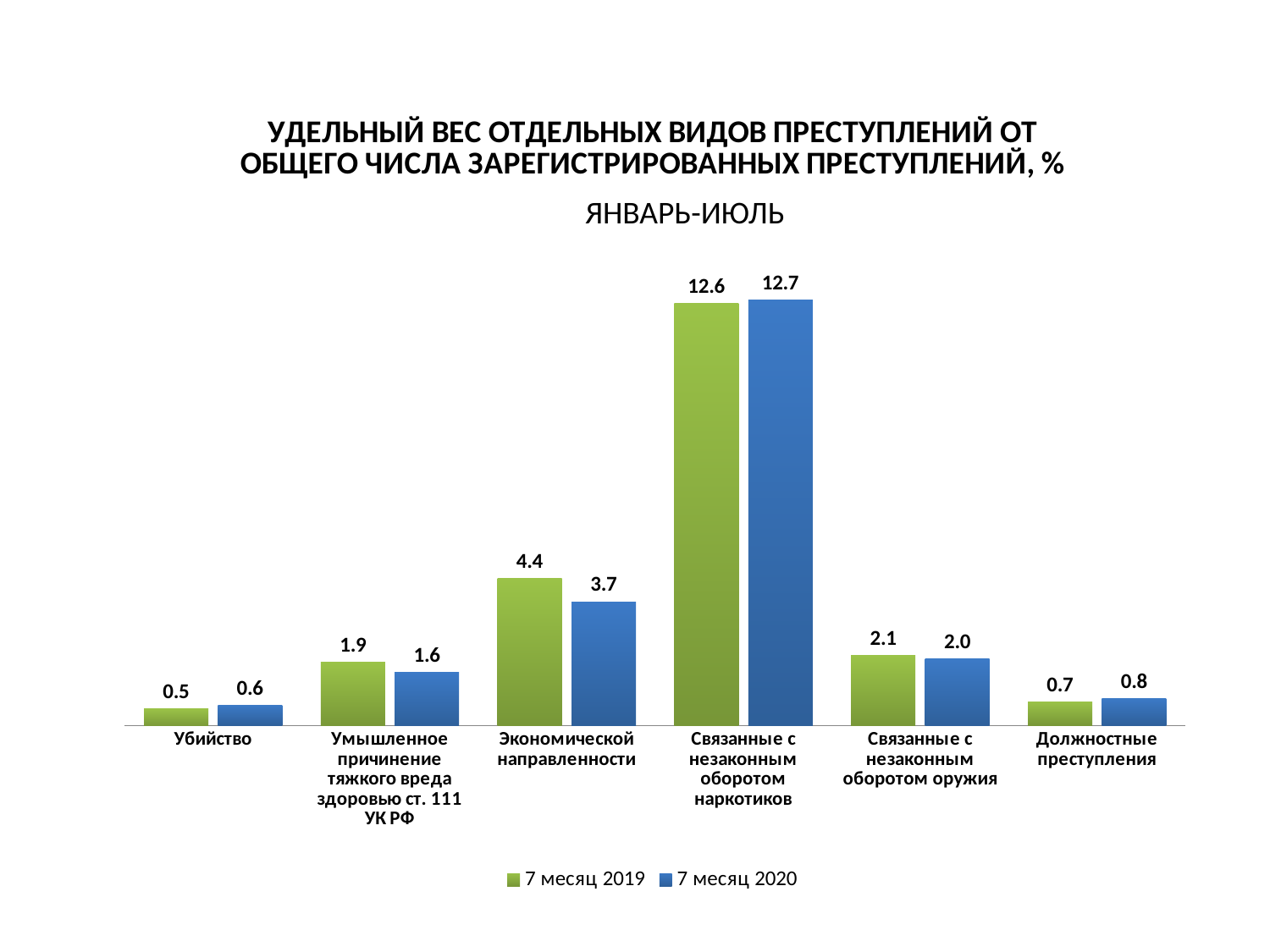
Which category has the lowest value in the 7 месяц 2020 series? Убийство What is the value for Умышленное причинение тяжкого вреда здоровью ст. 111 УК РФ in the 7 месяц 2020 series? 1.6 How many series does the legend list? 2 Which is larger for Должностные преступления: the 7 месяц 2019 value or the 7 месяц 2020 value? 7 месяц 2020 What is the value for Связанные с незаконным оборотом наркотиков in the 7 месяц 2020 series? 12.7 What kind of chart is shown on the slide? Bar chart What is the value for Экономической направленности in the 7 месяц 2019 series? 4.4 What is the difference between the 7 месяц 2019 and 7 месяц 2020 values for Экономической направленности? 0.7 What is the value for Убийство in the 7 месяц 2020 series? 0.6 How many categories are shown on the x axis? 6 Which category has the highest value in the 7 месяц 2019 series? Связанные с незаконным оборотом наркотиков What period is named in the subtitle below the chart title? ЯНВАРЬ-ИЮЛЬ